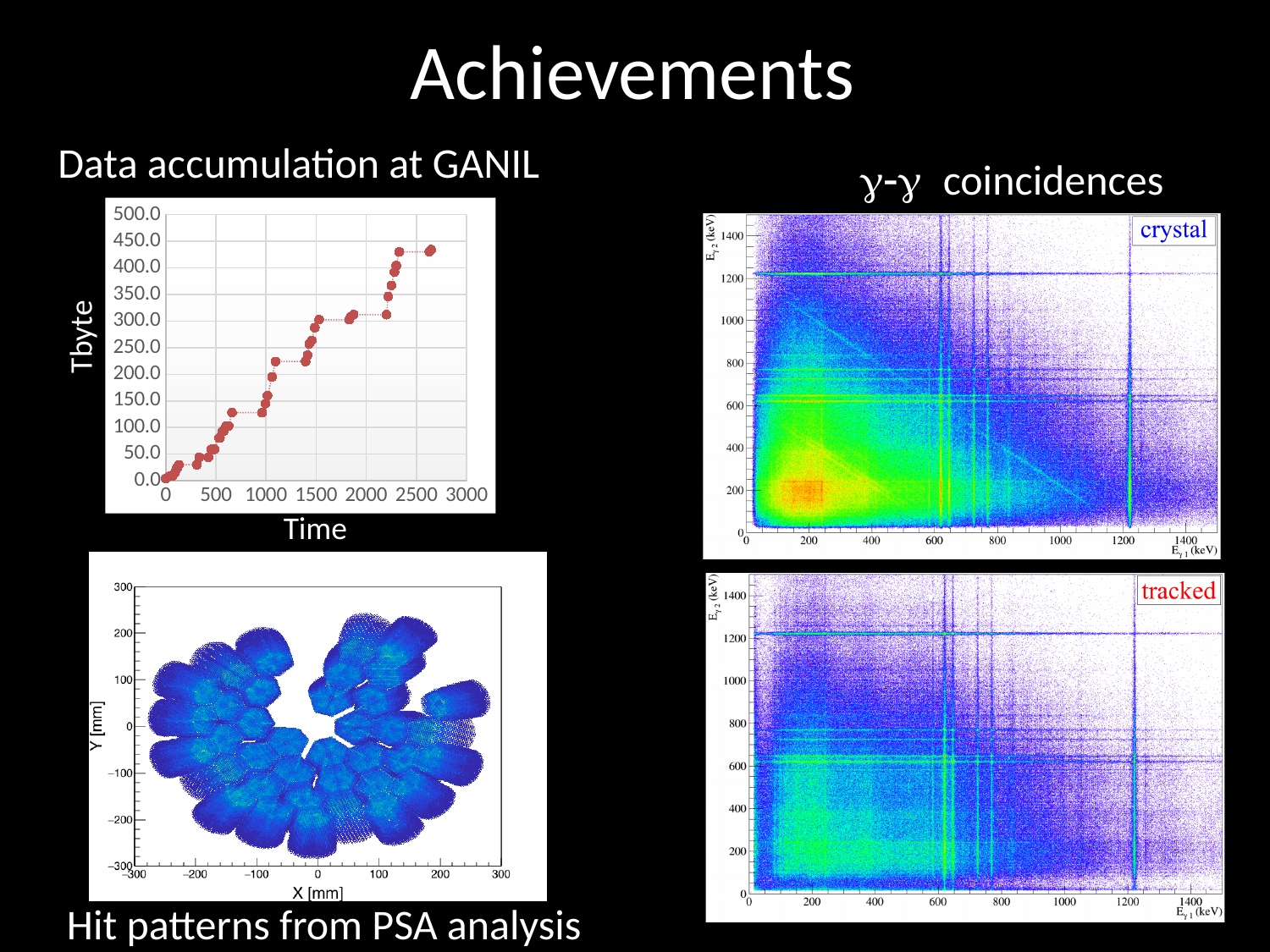
In the 'Data accumulation at GANIL' chart, what is the label on the y axis? Tbyte In the 'Data accumulation at GANIL' chart, is the value at Time 2000 greater or less than 250? greater In the 'Data accumulation at GANIL' chart, is the value at Time 500 greater or less than 100? less In the 'Data accumulation at GANIL' chart, is the highest plotted value greater or less than 400? greater In the 'Data accumulation at GANIL' chart, do the values rise or fall as Time increases? rise What are the two labels shown in the top-right corners of the two gamma-gamma coincidences plots? crystal and tracked In the 'Data accumulation at GANIL' chart, is the plotted value larger at Time 2500 or at Time 500? Time 2500 What kind of chart is the 'Data accumulation at GANIL' chart? scatter chart